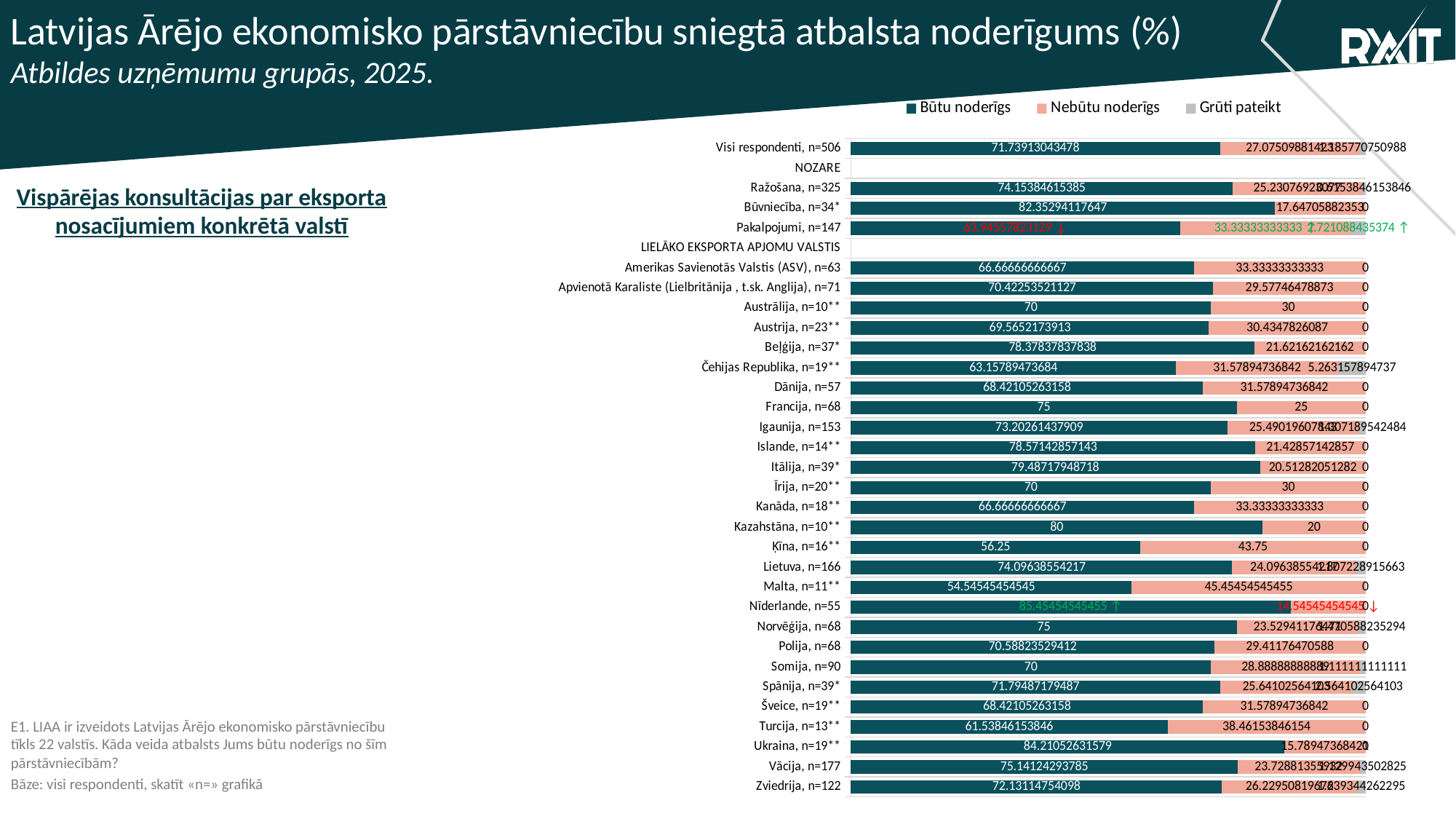
Which has a larger 'Būtu noderīgs' value: Ukraina, n=19** or Turcija, n=13**? Ukraina, n=19** What is the 'Nebūtu noderīgs' value for Ķīna, n=16**? 43.75 What is the 'Grūti pateikt' value for Čehijas Republika, n=19**? 5.263157894737 What is the 'Būtu noderīgs' value for Kazahstāna, n=10**? 80 How many series does the legend list? 3 What is the total of the stacked bar for Ķīna, n=16**? 100 Which group has the lowest 'Būtu noderīgs' value? Malta, n=11** What is the 'Būtu noderīgs' value for Visi respondenti, n=506? 71.73913043478 What is the difference between the 'Būtu noderīgs' values for Kazahstāna, n=10** and Ķīna, n=16**? 23.75 Which group has the highest 'Būtu noderīgs' value? Nīderlande, n=55 What kind of chart is shown on the slide? Stacked horizontal bar chart Which legend entry is shown in the dark teal colour? Būtu noderīgs